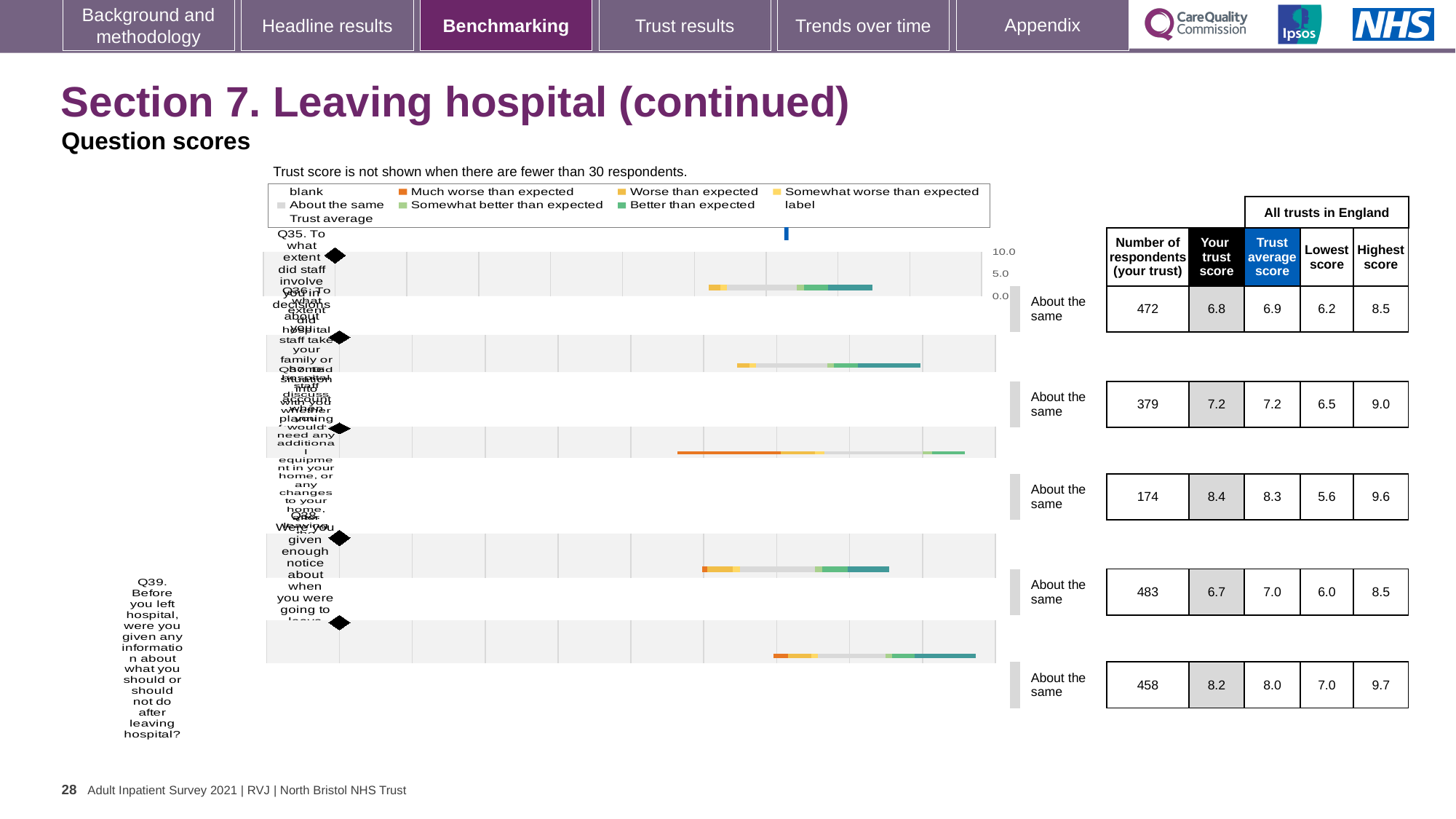
What is the difference between the trust score and the trust average score for Q39? 0.2 Which question has the lowest trust score on this slide? Q38 Which question has the highest trust score on this slide? Q37 For Q35, which is larger: the trust score or the trust average score? Trust average score What is the trust score for Q39 (information about what you should or should not do after leaving hospital)? 8.2 What is the trust average score for Q36 (family or home situation taken into account)? 7.2 What is the highest score across all trusts in England for Q39? 9.7 How many questions are plotted on this slide? 5 What kind of chart is used to show the question scores? Bar chart What benchmark category is shown for every question on this slide? About the same How many respondents answered Q38 (given enough notice about when you were going to leave)? 483 What is the lowest score across all trusts in England for Q37 (additional equipment or changes to your home)? 5.6